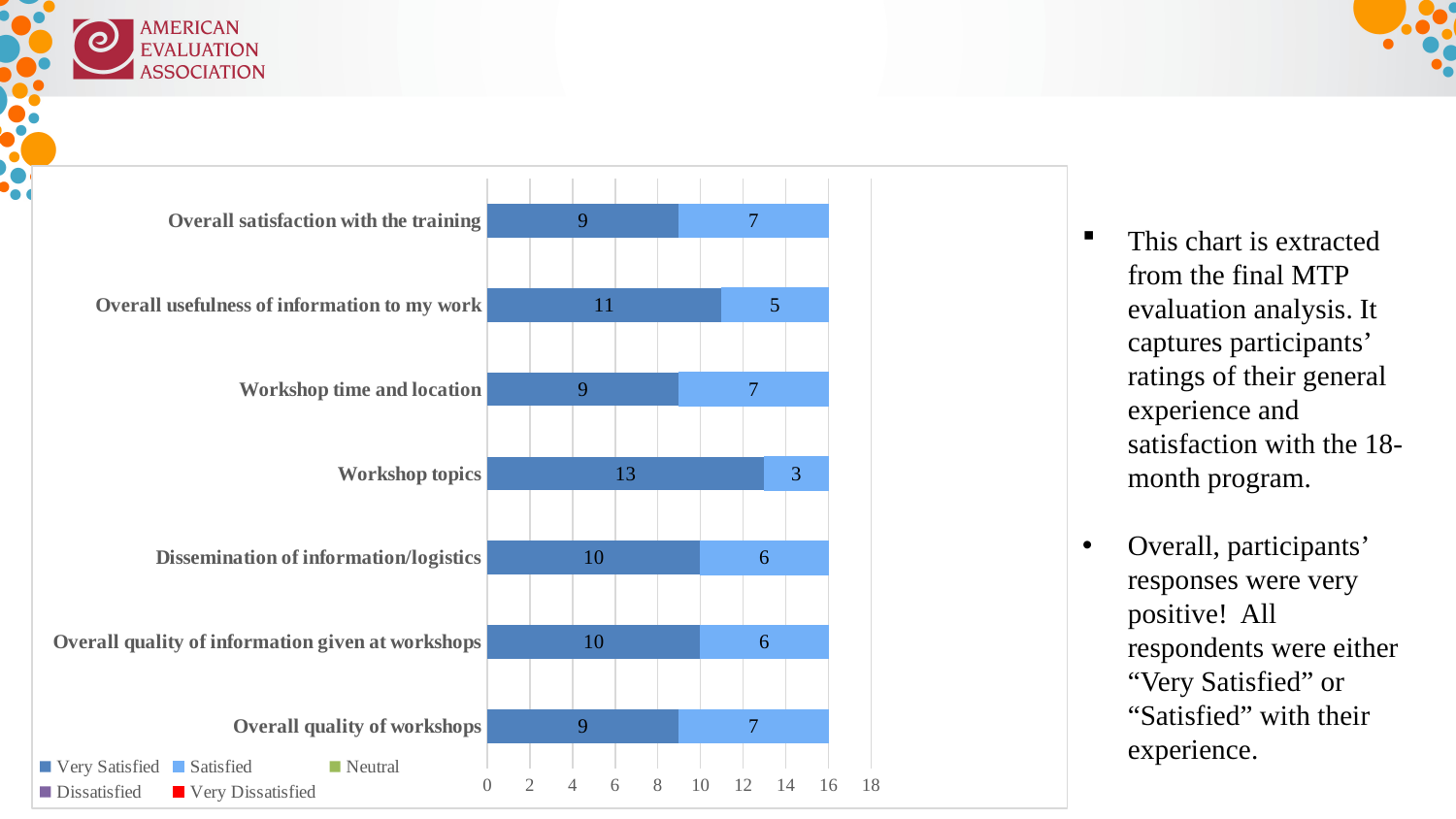
How many series does the legend list? 5 Which legend entry is shown in red? Very Dissatisfied What kind of chart is shown on the slide? Stacked bar chart Which is larger: the Very Satisfied value for Overall usefulness of information to my work or the Very Satisfied value for Workshop time and location? Overall usefulness of information to my work What is the Very Satisfied value for Dissemination of information/logistics? 10 What is the Very Satisfied value for Workshop topics? 13 What is the difference between the Very Satisfied and Satisfied values for Workshop topics? 10 What is the total of the stacked bar for Overall quality of workshops? 16 How many categories are plotted on the chart? 7 What is the Satisfied value for Overall usefulness of information to my work? 5 Which category has the highest Very Satisfied value? Workshop topics Which category has the lowest Satisfied value? Workshop topics